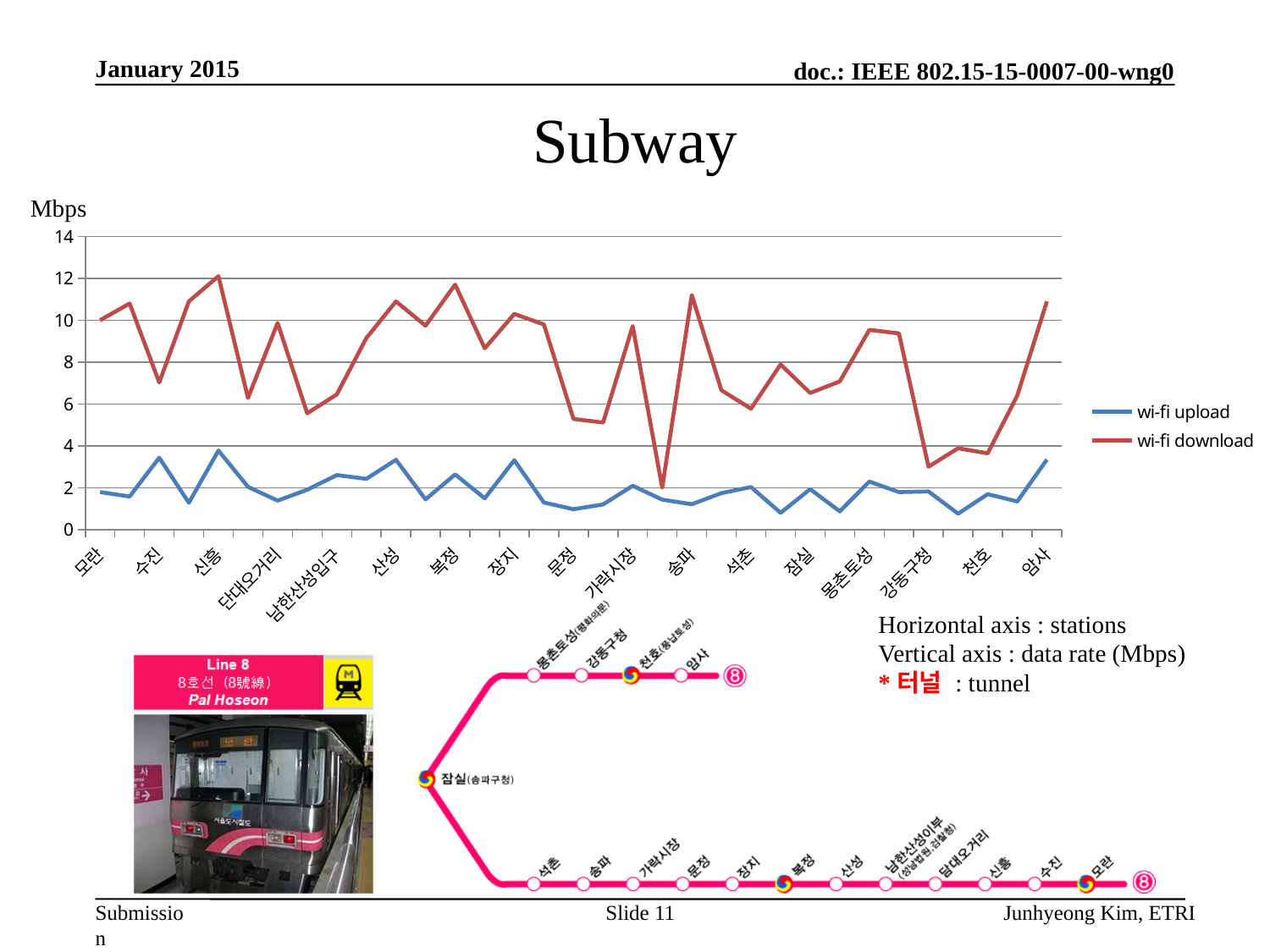
What kind of chart is shown on the slide? line chart Is the wi-fi upload value at 암사 greater or less than 6? less How many series does the chart legend list? 2 Is the wi-fi upload value at 모란 greater or less than 4? less Does the wi-fi upload line ever rise above 6 Mbps? no Which series stays higher across the stations, wi-fi upload or wi-fi download? wi-fi download Does the wi-fi download line rise or fall between 천호 and 암사? rise At 모란, which series has the larger value, wi-fi upload or wi-fi download? wi-fi download What are the two series named in the chart legend? wi-fi upload and wi-fi download Which colour is used for the wi-fi download line? red